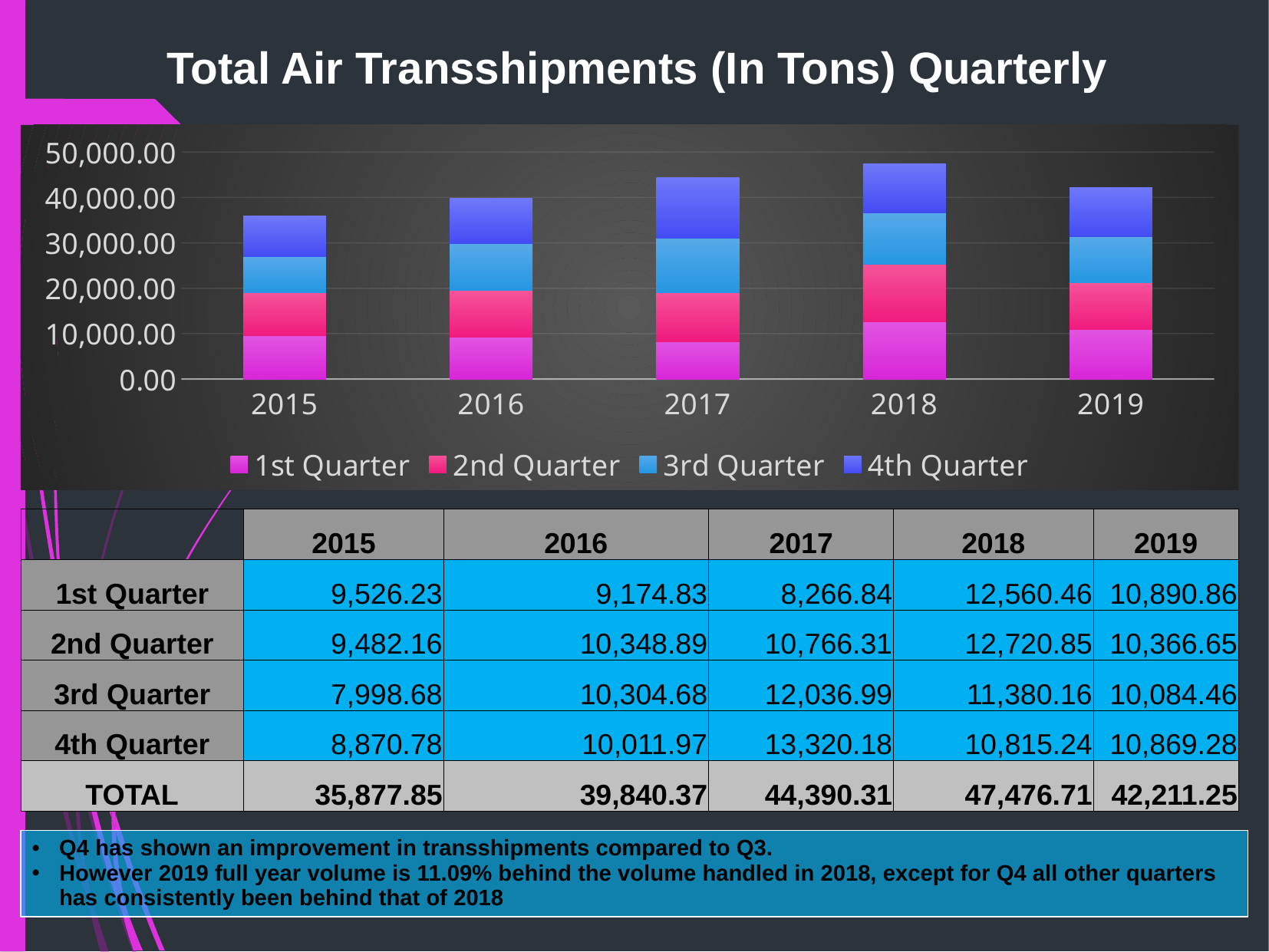
Is the total stacked bar for 2015 greater or less than 40,000.00? less What is the total of the stacked bar for 2018? 47,476.71 Which year has the shortest stacked bar? 2015 What kind of chart is shown on the slide? Stacked bar chart What is the title of the chart? Total Air Transshipments (In Tons) Quarterly What is the 4th Quarter value for 2017? 13,320.18 What is the 1st Quarter value for 2018? 12,560.46 What is the difference between the 2018 total and the 2019 total? 5,265.46 Which year has the larger total, 2016 or 2017? 2017 Which year has the tallest stacked bar? 2018 How many series does the chart legend list? 4 How many years are plotted along the x axis of the chart? 5